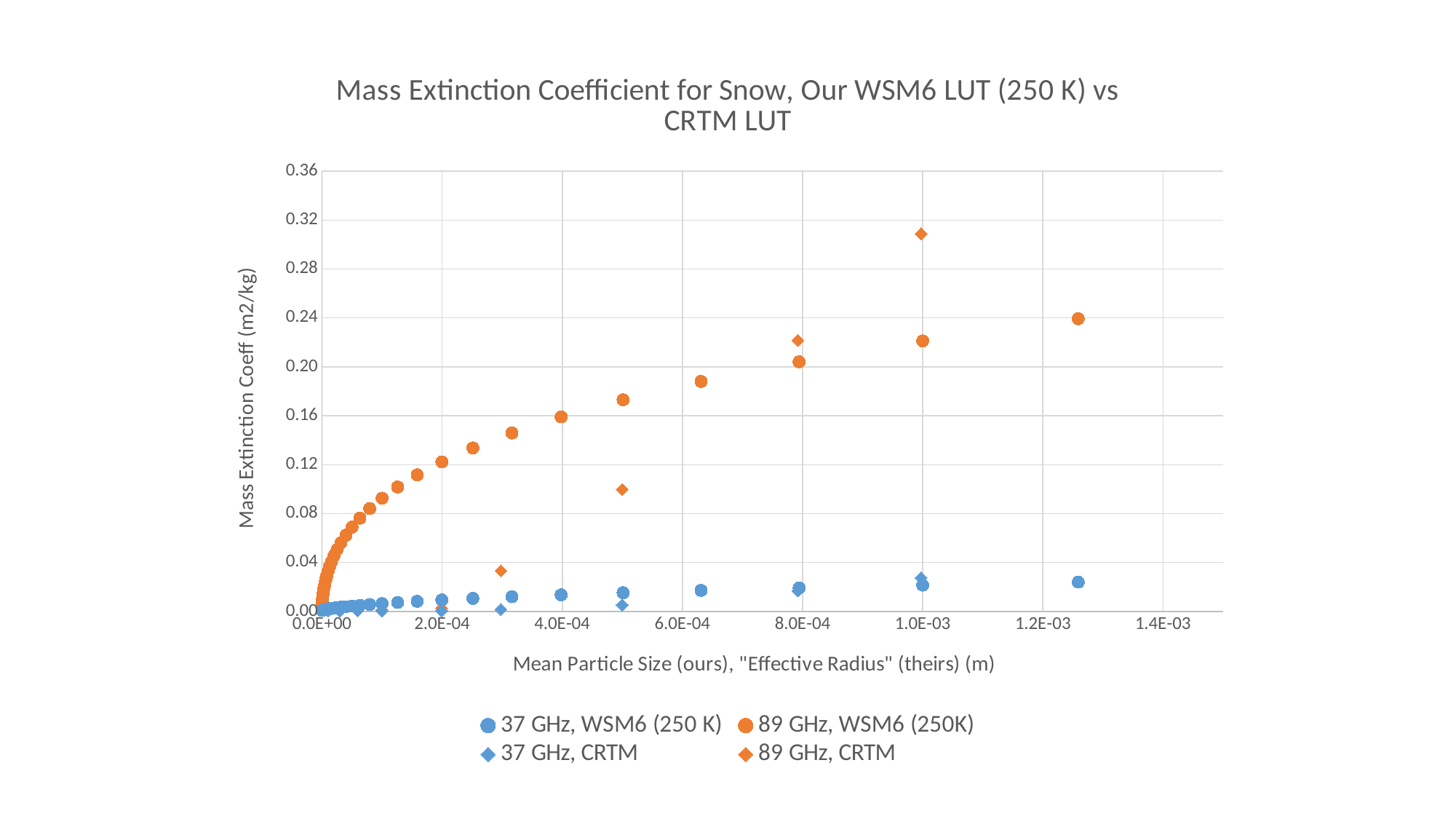
Is the value for 89 GHz, CRTM at a particle size of 1.0E-03 m greater or less than 0.28? greater Is the value for 89 GHz, WSM6 (250K) at a particle size of 1.0E-03 m greater or less than 0.20? greater Is the value for 37 GHz, WSM6 (250 K) at its largest particle size (about 1.26E-03 m) greater or less than 0.04? less Which series contains the single highest plotted value on the chart? 89 GHz, CRTM At a particle size of 1.0E-03 m, which is larger: 89 GHz, CRTM or 89 GHz, WSM6 (250K)? 89 GHz, CRTM Do the values for 89 GHz, WSM6 (250K) rise or fall as mean particle size increases? rise What kind of chart is shown on the slide? scatter chart At a particle size of 5.0E-04 m, which is larger: 89 GHz, WSM6 (250K) or 89 GHz, CRTM? 89 GHz, WSM6 (250K) What is the label of the vertical axis? Mass Extinction Coeff (m2/kg) How many series does the legend list? 4 What is the title of the chart? Mass Extinction Coefficient for Snow, Our WSM6 LUT (250 K) vs CRTM LUT